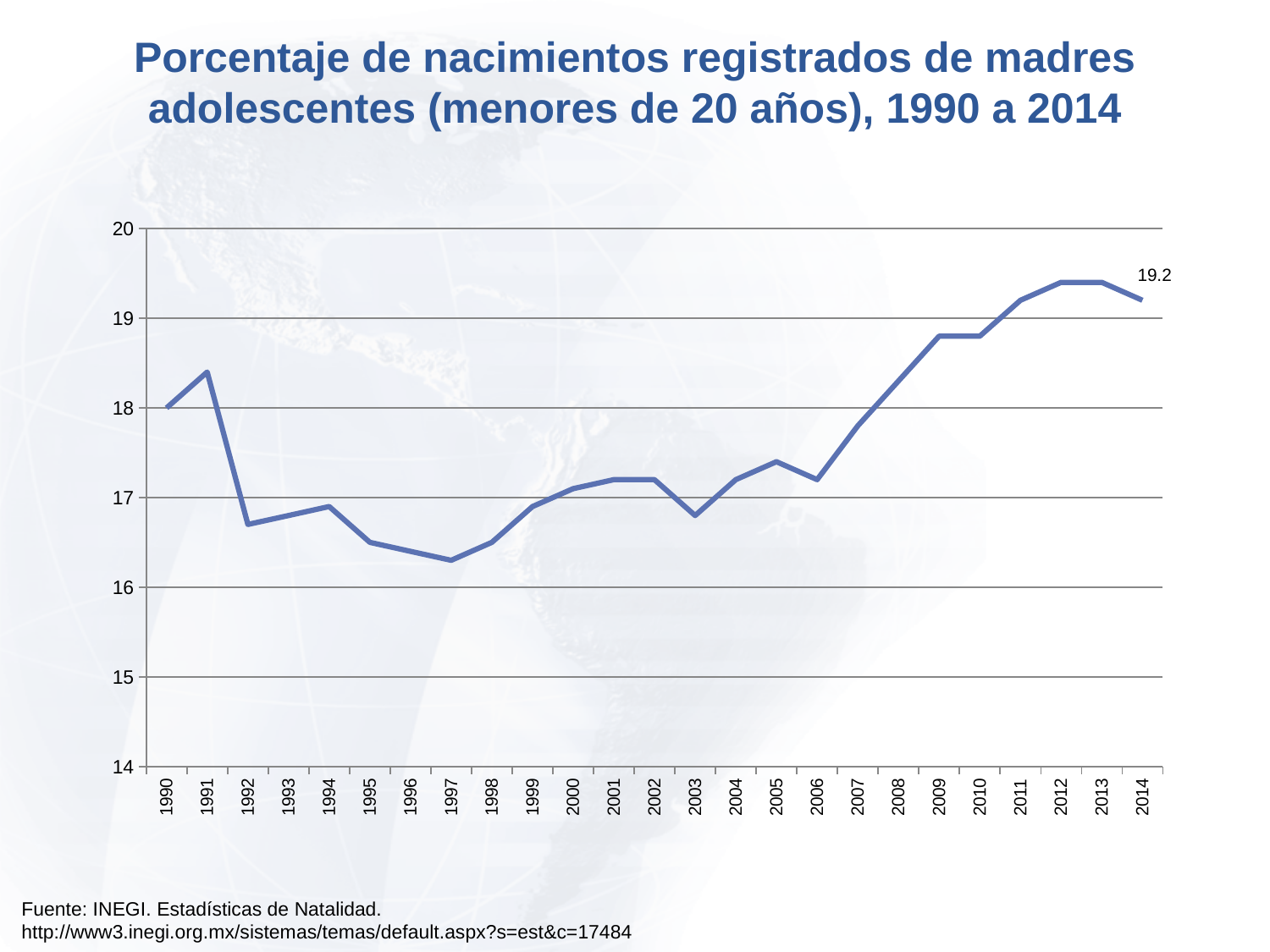
Do the values rise or fall between 2006 and 2012? rise Is the value for 2009 greater or less than 19? less What kind of chart is shown on the slide? line chart What is the value shown for 2014? 19.2 Is the value for 2011 greater or less than 19? greater Which year has the larger value, 1991 or 1992? 1991 Is the value for 1992 greater or less than 17? less What period does the chart title say the data covers? 1990 a 2014 Do the values rise or fall between 1991 and 1997? fall How many years (data points) are plotted along the x axis? 25 Which year has the larger value, 1990 or 2014? 2014